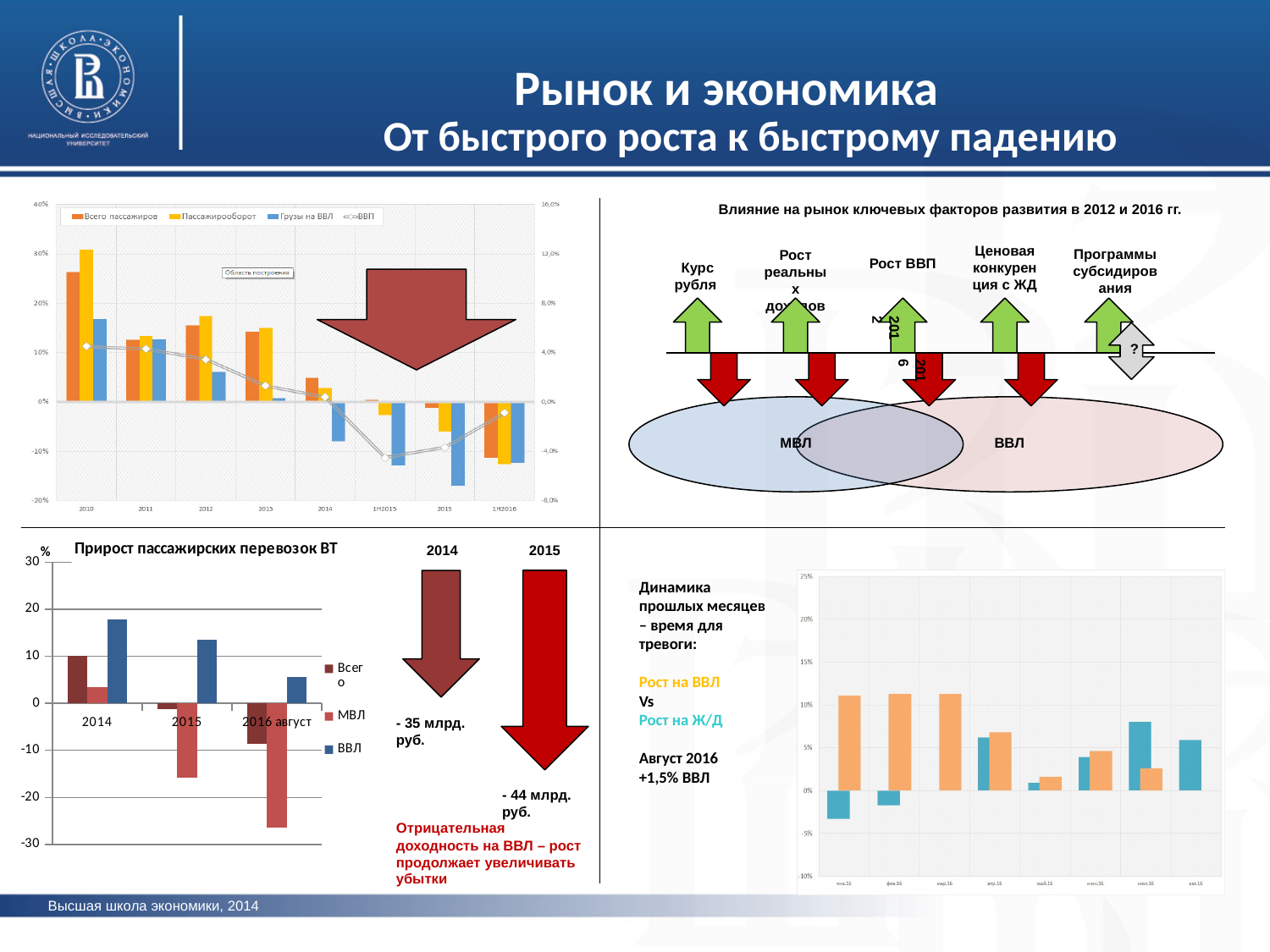
In the 'Прирост пассажирских перевозок ВТ' chart, is the value for ВВЛ in 2014 greater or less than 10? greater How many categories are shown on the x axis of the bottom-right chart? 8 How many series does the legend of the 'Прирост пассажирских перевозок ВТ' chart list? 3 How many categories are shown on the x axis of the top-left chart? 8 In the 'Прирост пассажирских перевозок ВТ' chart, is the value for МВЛ in 2016 август greater or less than -20? less How many categories are shown on the x axis of the 'Прирост пассажирских перевозок ВТ' chart? 3 What kind of chart is the 'Прирост пассажирских перевозок ВТ' chart at the bottom left? bar chart In the 'Прирост пассажирских перевозок ВТ' chart, which category has the lowest value for МВЛ? 2016 август How many series does the legend of the top-left chart list? 4 In the 'Прирост пассажирских перевозок ВТ' chart, which is larger: ВВЛ in 2014 or ВВЛ in 2015? ВВЛ in 2014 In the top-left chart, is the value for Всего пассажиров in 2010 greater or less than 20%? greater What are the legend entries of the 'Прирост пассажирских перевозок ВТ' chart? Всего, МВЛ, ВВЛ